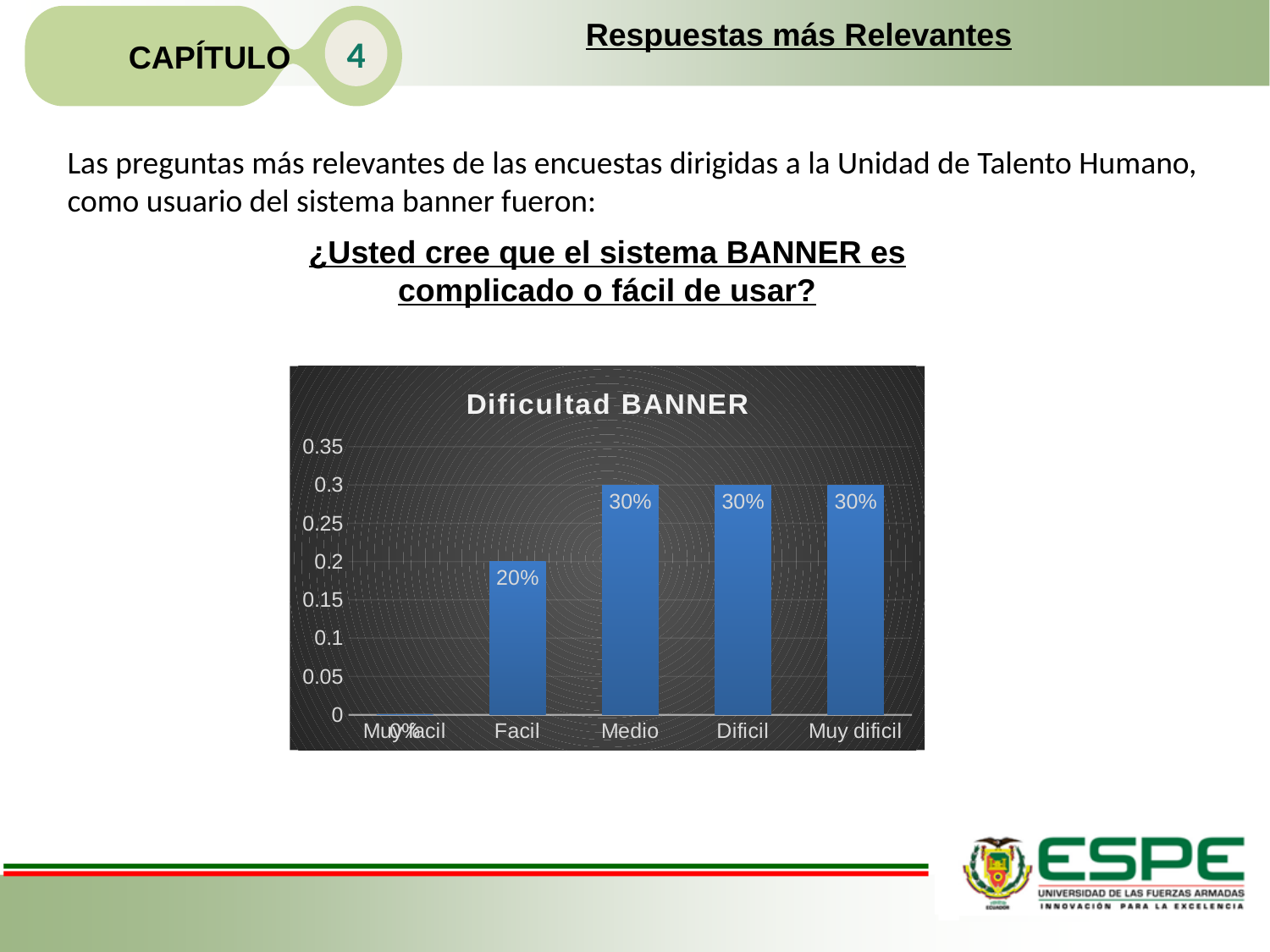
What kind of chart is the Dificultad BANNER chart? bar chart Is the value for Facil in the Dificultad BANNER chart greater or less than 0.25? less What is the title of the chart on the slide? Dificultad BANNER Which category has the lowest value in the Dificultad BANNER chart? Muy facil Do the values rise or fall from Muy facil to Medio in the Dificultad BANNER chart? rise Which is larger in the Dificultad BANNER chart, the value for Facil or the value for Dificil? Dificil How many categories are shown in the Dificultad BANNER chart? 5 What is the value for Muy facil in the Dificultad BANNER chart? 0% What is the value for Muy dificil in the Dificultad BANNER chart? 30% What is the value for Medio in the Dificultad BANNER chart? 30% What is the value for Facil in the Dificultad BANNER chart? 20% What is the difference between the values for Medio and Facil in the Dificultad BANNER chart? 10%